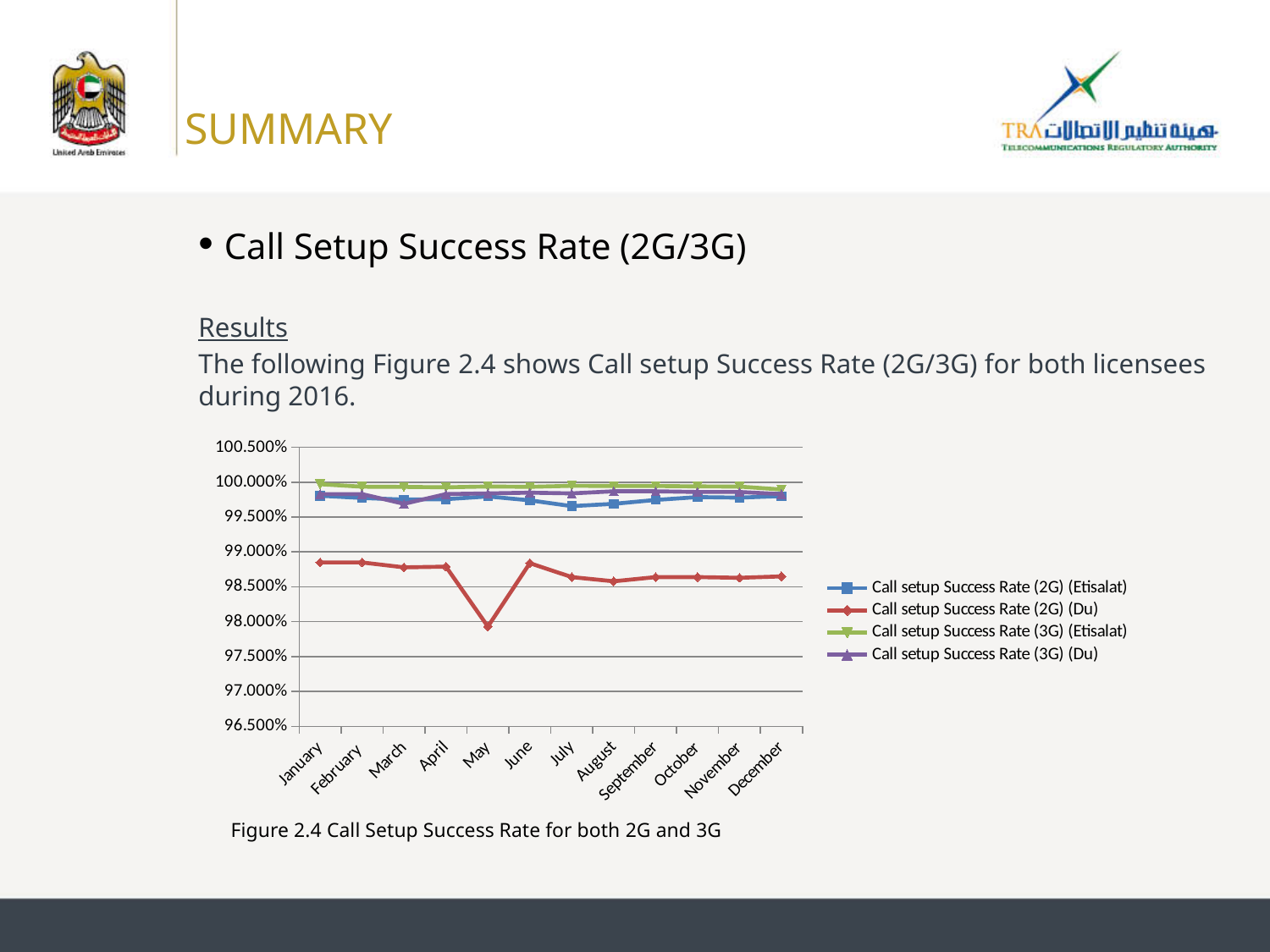
Which series has the lowest values throughout the year in the chart? Call setup Success Rate (2G) (Du) What is the caption given below the chart? Figure 2.4 Call Setup Success Rate for both 2G and 3G Is the Call setup Success Rate (2G) (Du) value for August greater or less than 99.000%? less In which month does the Call setup Success Rate (2G) (Du) series reach its lowest value? May In July, which is larger: Call setup Success Rate (2G) (Etisalat) or Call setup Success Rate (2G) (Du)? Call setup Success Rate (2G) (Etisalat) In March, which is larger: Call setup Success Rate (3G) (Etisalat) or Call setup Success Rate (3G) (Du)? Call setup Success Rate (3G) (Etisalat) Is the Call setup Success Rate (2G) (Du) value for January greater or less than 98.500%? greater How many months are plotted along the x axis of the chart? 12 How many series does the legend of the chart list? 4 Is the Call setup Success Rate (2G) (Du) value for May greater or less than 98.500%? less What kind of chart is shown in Figure 2.4? line chart